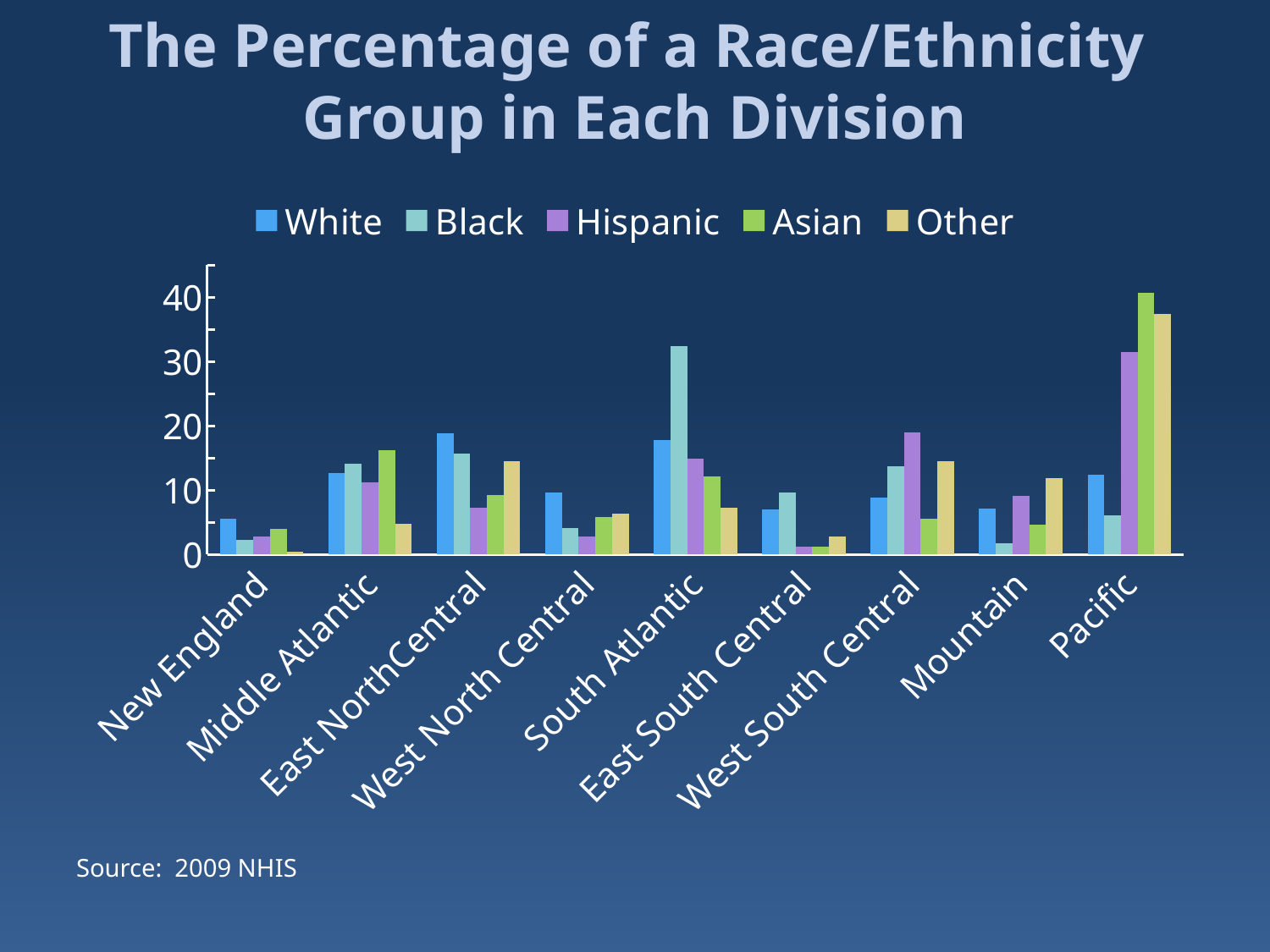
What kind of chart is shown on the slide? bar chart In which division is the Asian bar the highest? Pacific In the West South Central division, which is larger: the Hispanic bar or the White bar? Hispanic Is the value for Hispanic in Pacific greater or less than 20? greater In which division is the Other bar the lowest? New England How many divisions are shown along the x axis? 9 Is the value for Black in South Atlantic greater or less than 30? greater In which division is the Black bar the highest? South Atlantic How many series does the legend list? 5 Is the value for Other in Pacific greater or less than 30? greater In the Pacific division, which is larger: the Asian bar or the Black bar? Asian